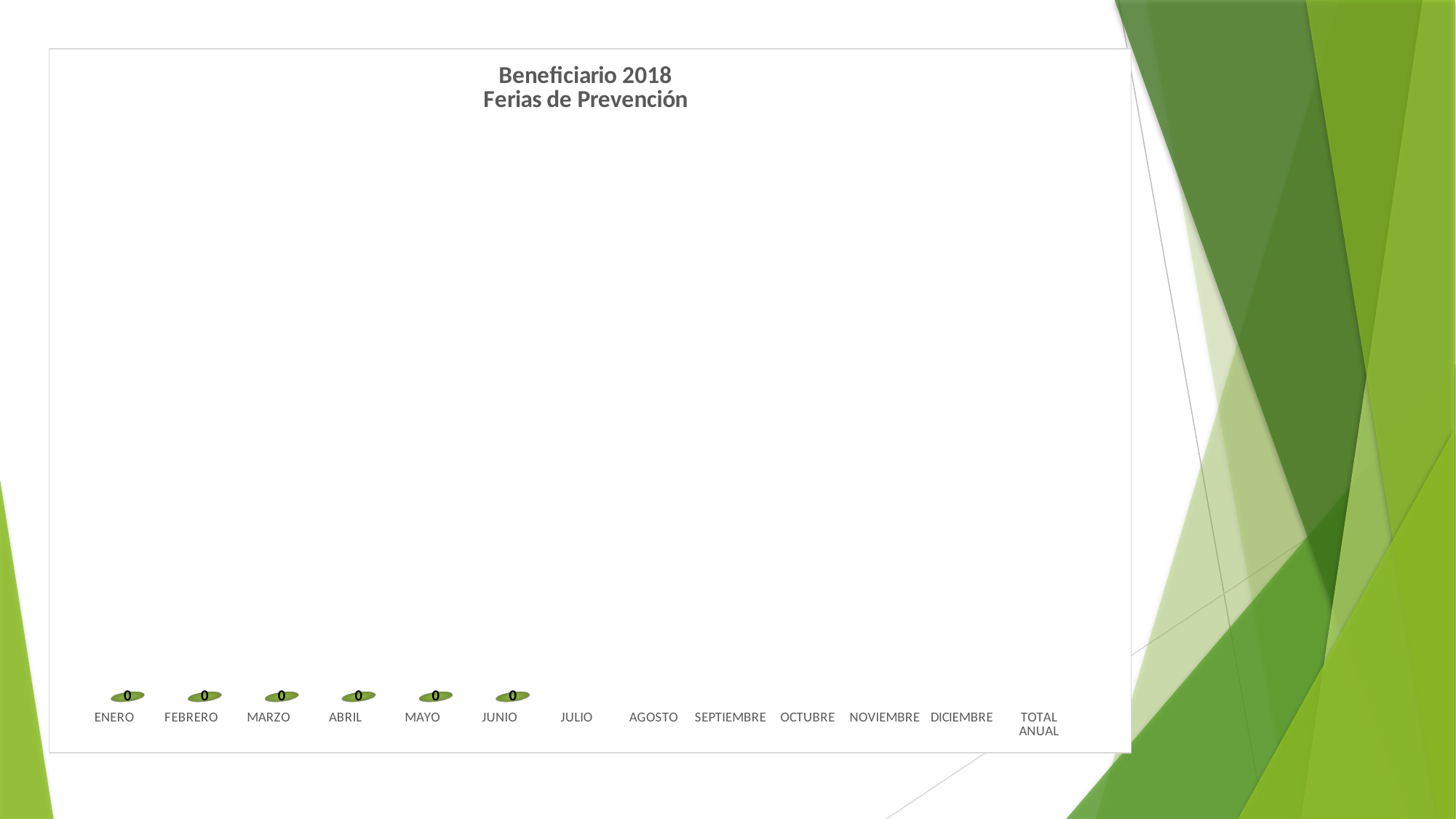
What is the label of the last category on the x axis? TOTAL ANUAL What kind of chart is this? bar chart What is the difference between the values for ENERO and MAYO? 0 Do the values rise, fall or stay flat from ENERO to JUNIO? stay flat How many categories have a data label printed on the chart? 6 How many categories are shown on the x axis? 13 What is the value for ABRIL? 0 What is the title of the chart? Beneficiario 2018 Ferias de Prevención What is the value for MARZO? 0 What is the value for JUNIO? 0 What is the value for ENERO? 0